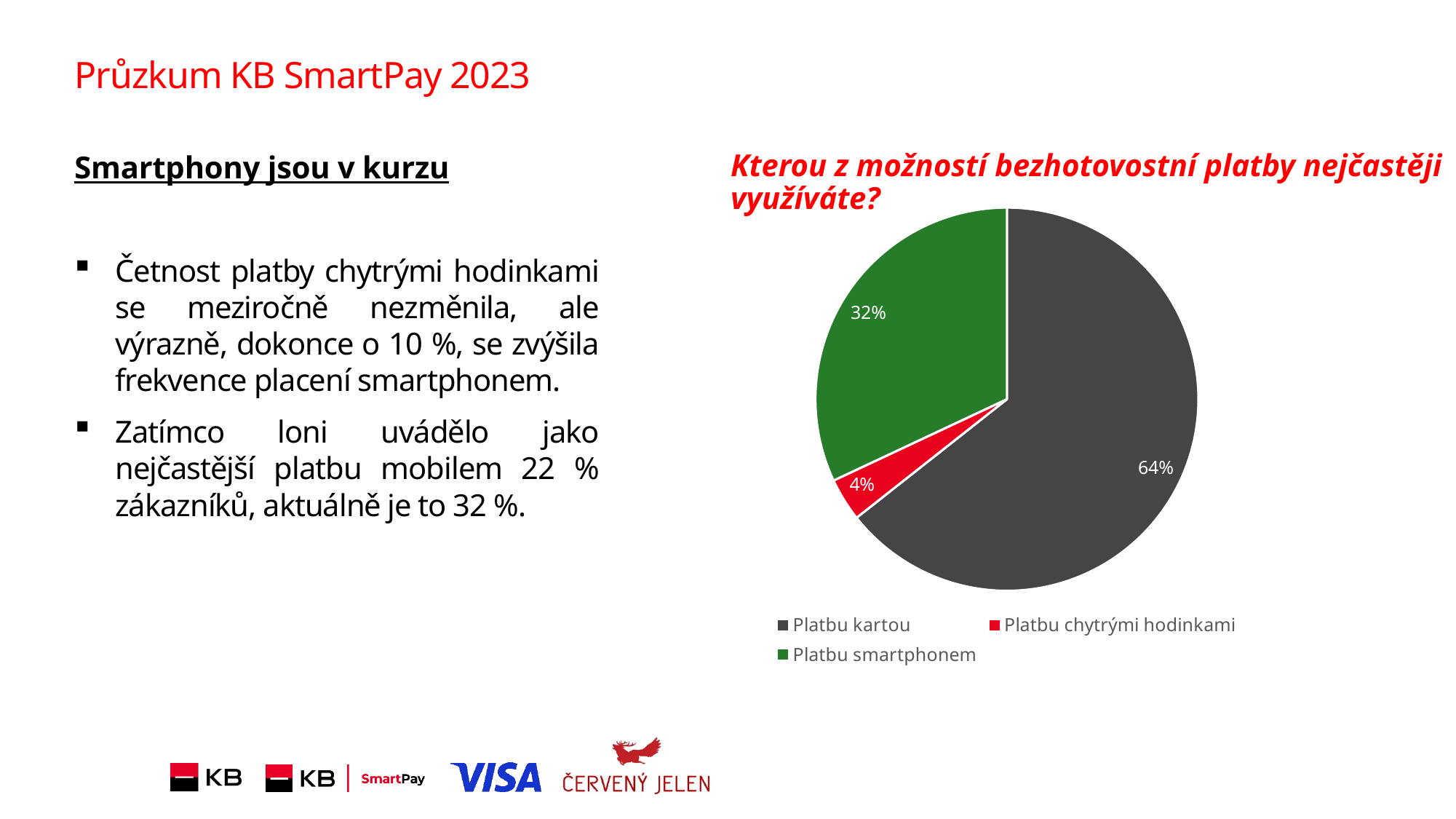
What percentage of respondents most often pay with a smartwatch (Platbu chytrými hodinkami)? 4% Which is larger: the share for Platbu smartphonem or the share for Platbu chytrými hodinkami? Platbu smartphonem How many categories does the pie chart show? 3 What percentage of respondents most often pay by smartphone (Platbu smartphonem)? 32% What percentage of respondents most often use card payment (Platbu kartou)? 64% What is the difference in percentage points between smartphone payment and smartwatch payment? 28 What kind of chart is shown on the slide? pie chart What colour is the slice for Platbu smartphonem? green What is the title of the pie chart? Kterou z možností bezhotovostní platby nejčastěji využíváte? Which payment option has the largest share of the pie? Platbu kartou What is the difference in percentage points between card payment and smartphone payment? 32 Which payment option has the smallest share of the pie? Platbu chytrými hodinkami